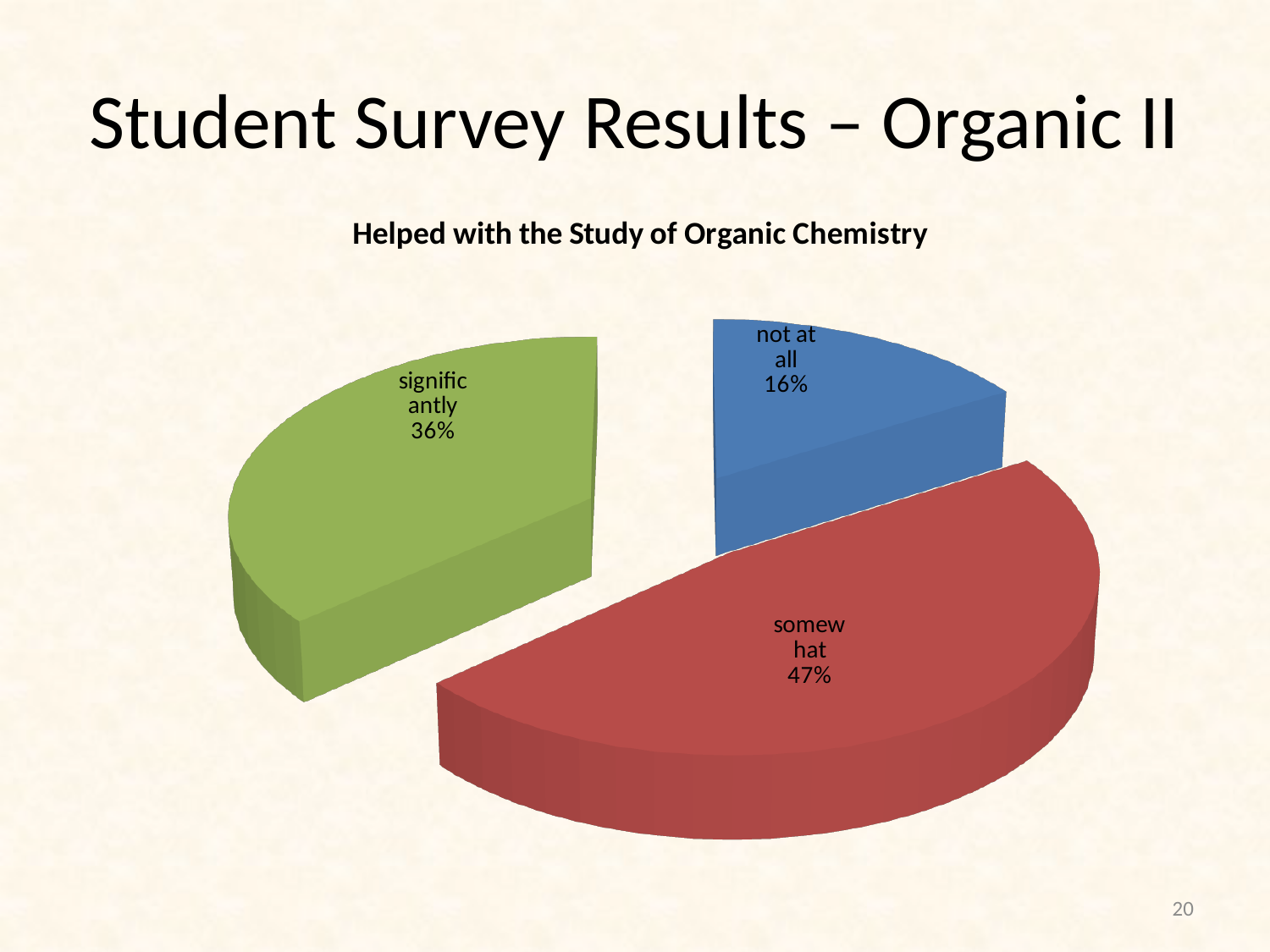
What is the difference in percentage points between the 'somewhat' and 'significantly' slices? 11 What kind of chart is shown on the slide? pie chart Which response category has the largest share of the pie? somewhat Which is larger: the 'significantly' slice or the 'not at all' slice? significantly What is the title of the chart? Helped with the Study of Organic Chemistry What percentage of students said the course helped 'somewhat' with the study of organic chemistry? 47% What is the difference in percentage points between the 'significantly' and 'not at all' slices? 20 What percentage of students said the course did 'not at all' help? 16% What percentage of students said the course helped 'significantly'? 36% How many response categories are shown in the pie chart? 3 Which response category has the smallest share of the pie? not at all What colour is the 'somewhat' slice? red